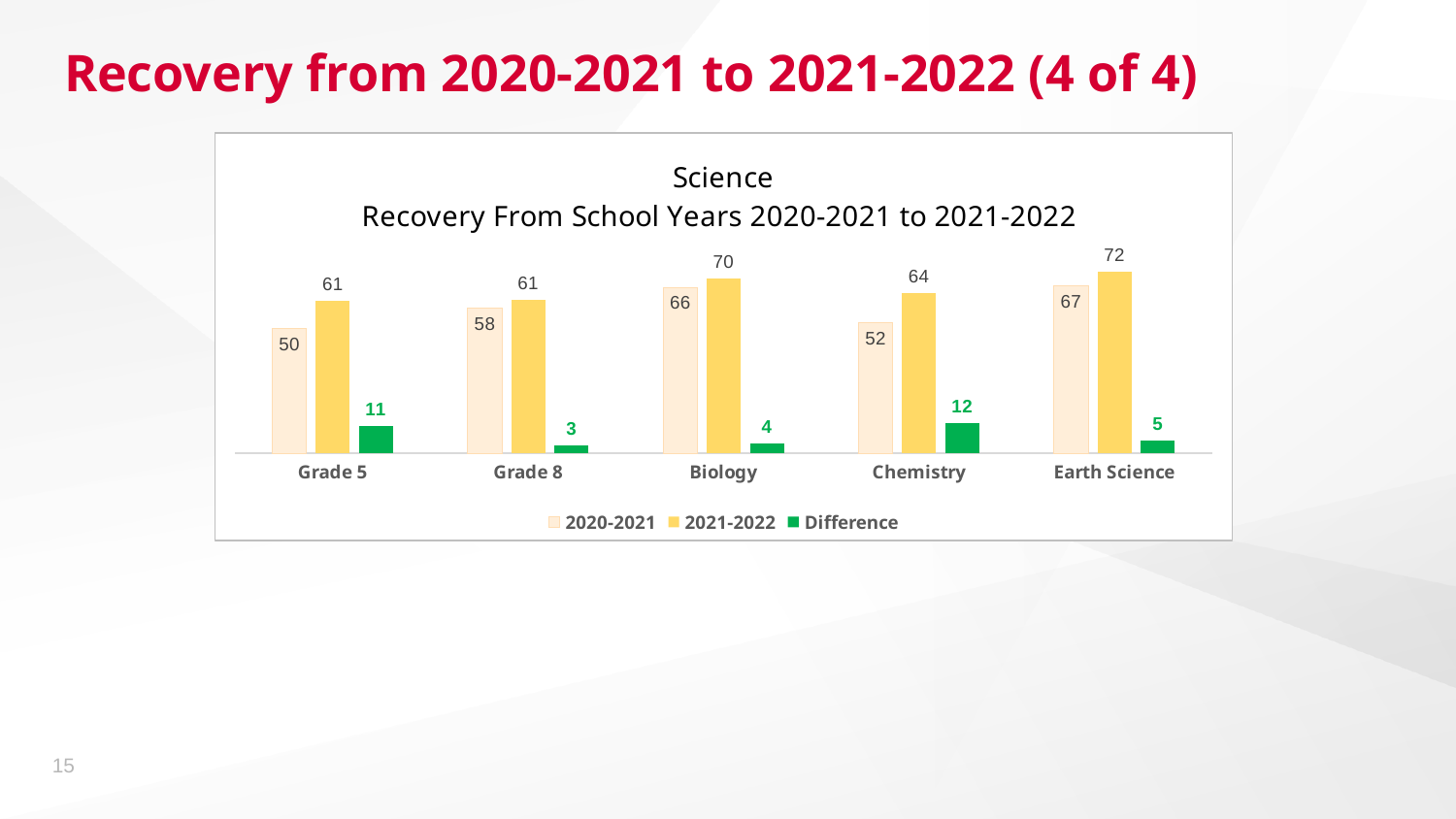
Which category has the smallest Difference value? Grade 8 Which category has the lowest 2020-2021 value? Grade 5 Which is larger, the 2020-2021 value for Biology or the 2020-2021 value for Chemistry? Biology What is the difference between the 2021-2022 and 2020-2021 values for Earth Science? 5 What is the title of the chart? Science Recovery From School Years 2020-2021 to 2021-2022 Which category has the highest 2021-2022 value? Earth Science How many categories are shown on the x axis? 5 What is the 2021-2022 value for Biology? 70 What is the 2020-2021 value for Grade 5? 50 What is the Difference value for Chemistry? 12 What kind of chart is shown? Bar chart How many series does the legend list? 3